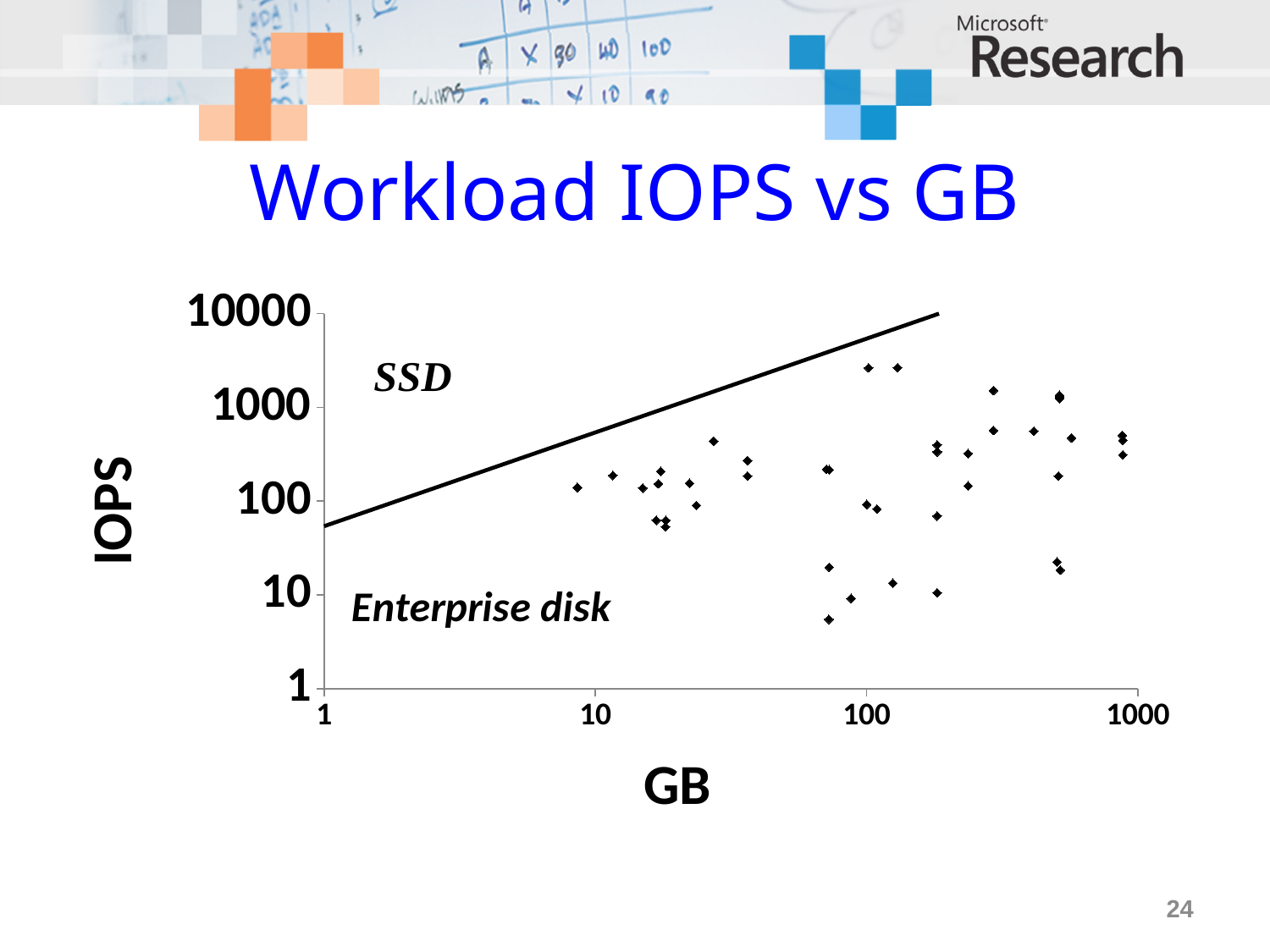
Do the plotted points lie above or below the diagonal line? Below What kind of chart is shown on the slide? Scatter plot What label is on the y axis of the chart? IOPS What is the highest tick value shown on the y axis? 10000 What is the title of the chart? Workload IOPS vs GB